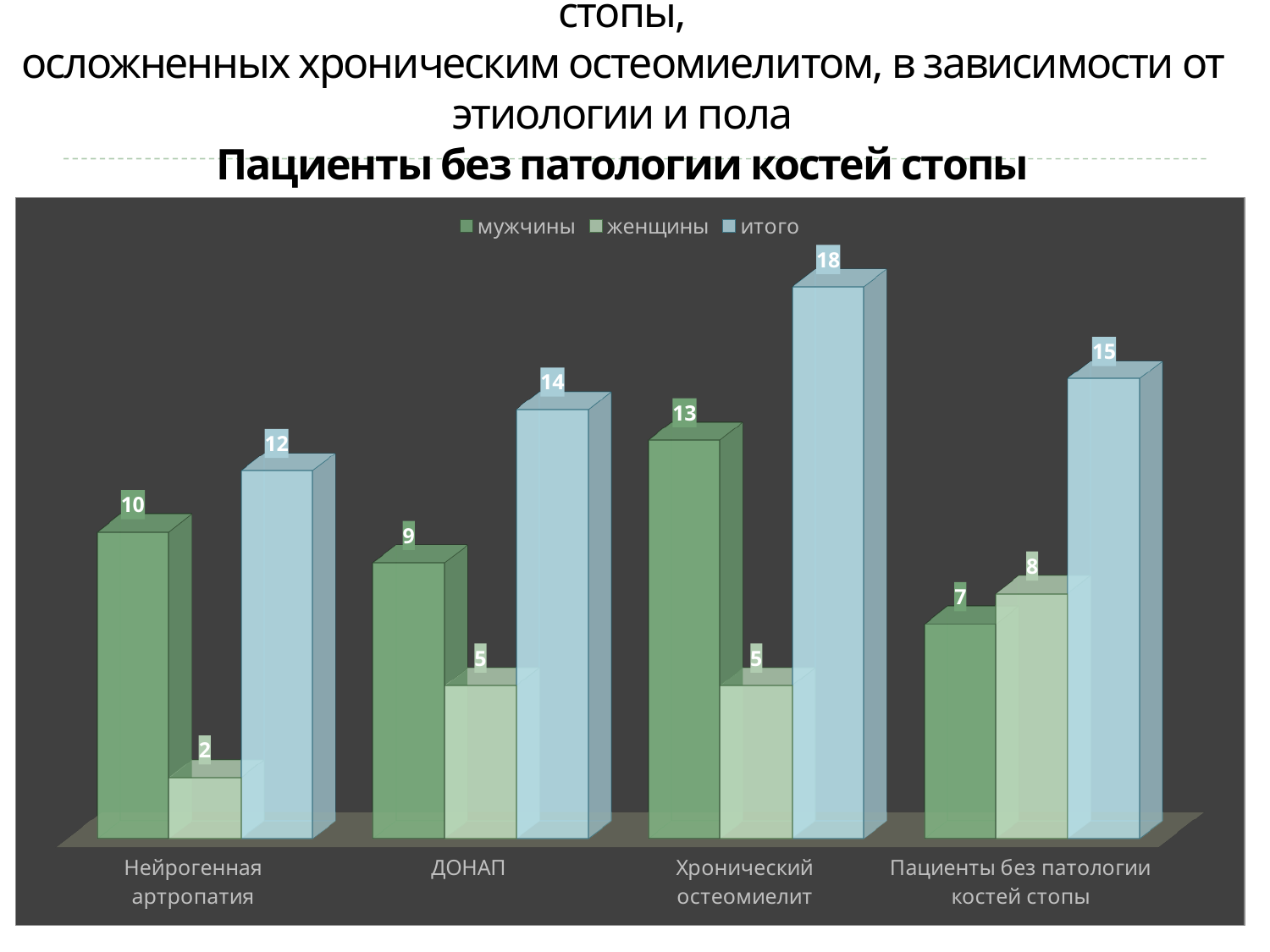
What is the difference between the мужчины and женщины values for Нейрогенная артропатия? 8 How many series does the legend list? 3 Which category has the lowest value for женщины? Нейрогенная артропатия What is the итого value for Хронический остеомиелит? 18 Which category has the highest итого value? Хронический остеомиелит What are the three series named in the legend? мужчины, женщины, итого What kind of chart is shown on the slide? bar chart What is the value for женщины in the Пациенты без патологии костей стопы category? 8 What is the value for мужчины in the Нейрогенная артропатия category? 10 Which is larger for Пациенты без патологии костей стопы: the мужчины value or the женщины value? женщины What is the value for женщины in the ДОНАП category? 5 How many categories are shown on the x axis? 4